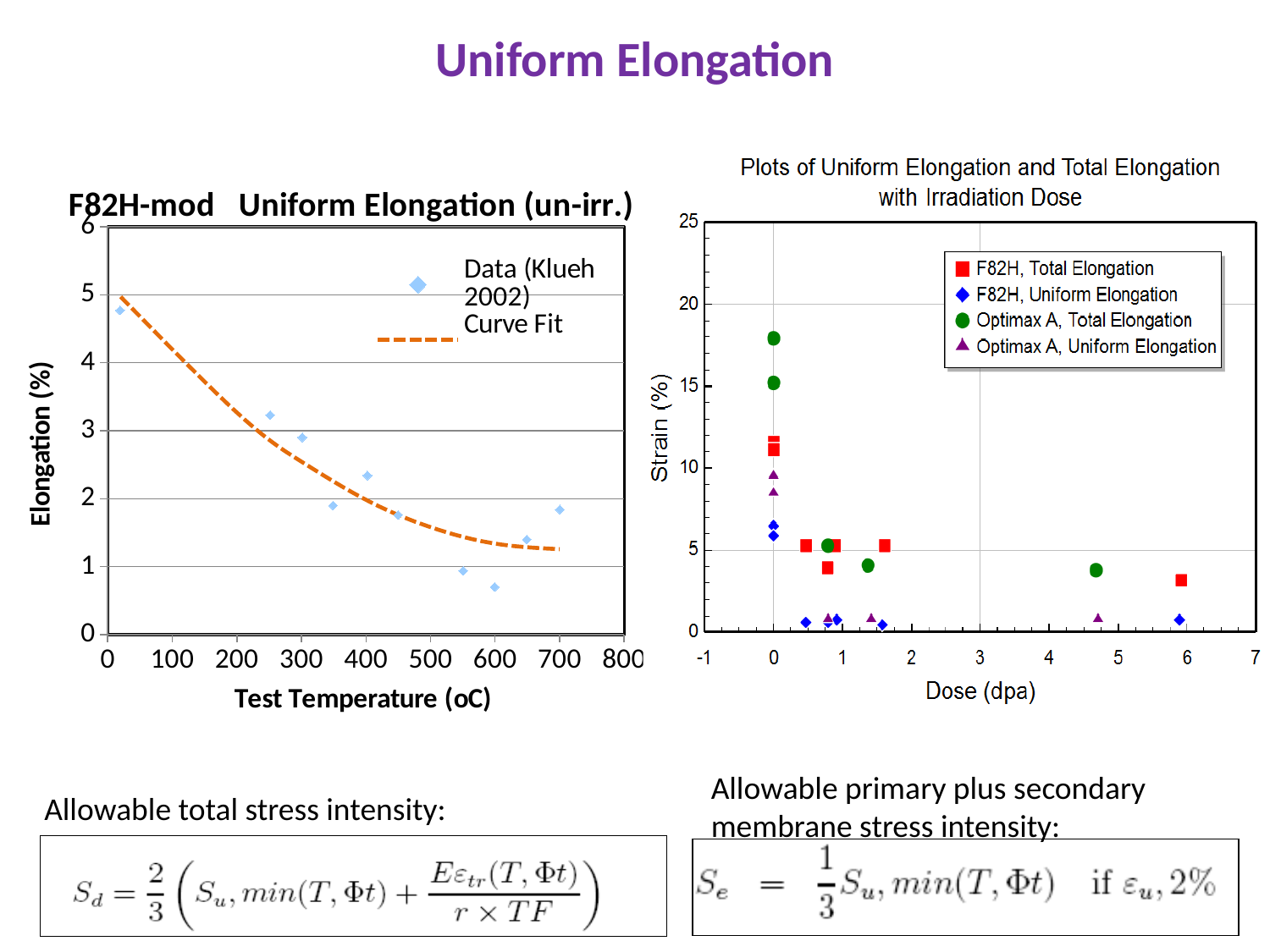
In the left chart, how many entries does the legend list? 2 In the left chart, which is larger: the elongation at 250 °C or the elongation at 550 °C? 250 °C In the right chart, what is the label of the y axis? Strain (%) In the right chart, is the highest Optimax A Total Elongation value (at 0 dpa) greater or less than 15? greater In the right chart, does the F82H Total Elongation generally rise or fall as dose increases? fall What kind of chart is the left chart titled "F82H-mod Uniform Elongation (un-irr.)"? scatter chart In the right chart, is the F82H Total Elongation value at about 6 dpa greater or less than 5? less In the left chart, do the data points generally rise or fall as test temperature increases? fall In the left chart, what is the label of the x axis? Test Temperature (oC) In the left chart, is the elongation value of the data point at 600 °C greater or less than 1? less In the right chart titled "Plots of Uniform Elongation and Total Elongation with Irradiation Dose", how many series does the legend list? 4